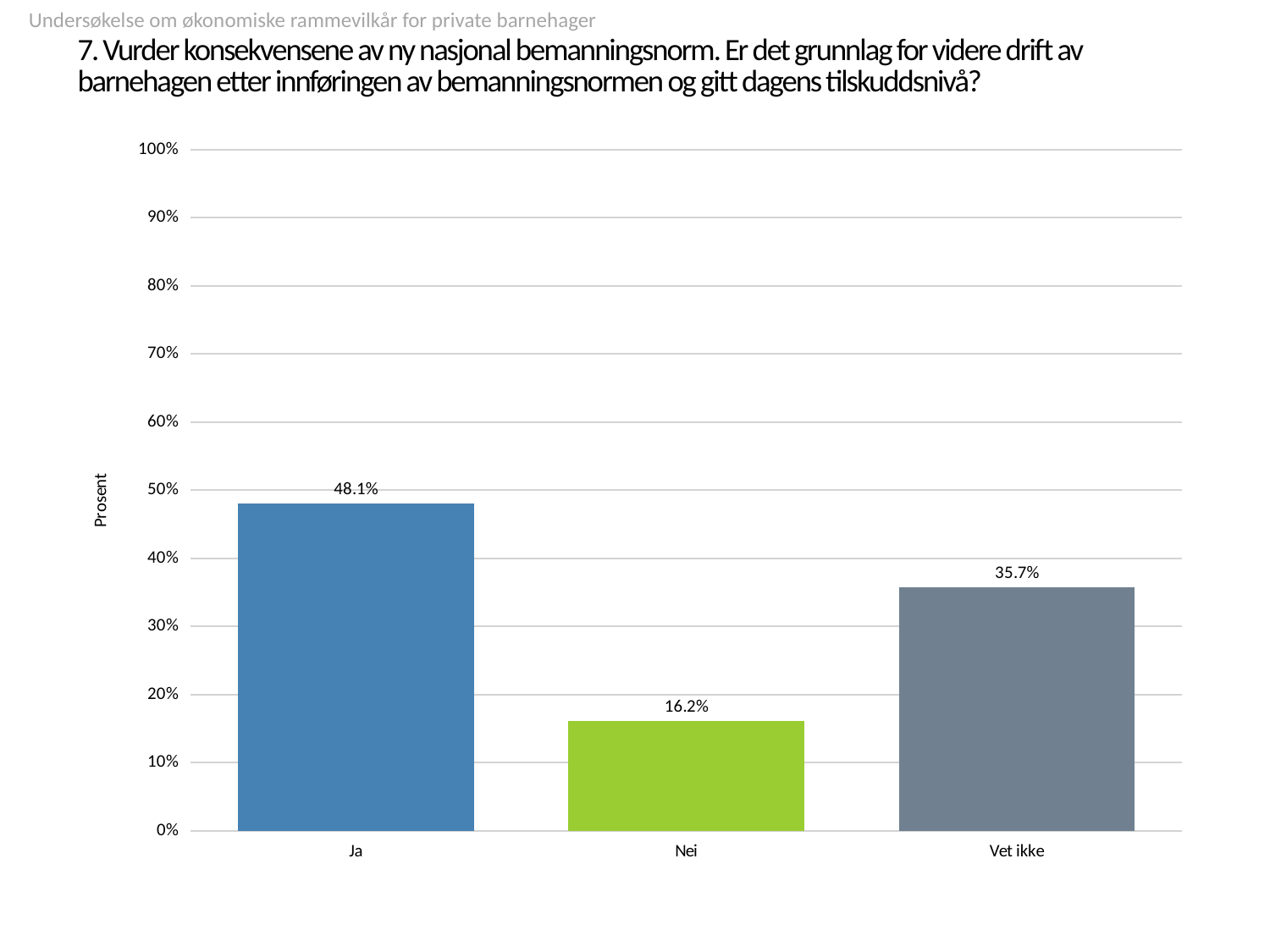
What kind of chart is shown on the slide? bar chart What is the label of the y axis? Prosent What is the value for "Ja"? 48.1% What is the value for "Vet ikke"? 35.7% Which category has the lowest value? Nei What is the difference between the values for "Vet ikke" and "Nei"? 19.5% What is the value for "Nei"? 16.2% What is the difference between the values for "Ja" and "Vet ikke"? 12.4% Which is larger, the value for "Nei" or the value for "Vet ikke"? Vet ikke How many categories are shown on the x axis? 3 Is the value for "Ja" greater or less than 50%? less Which category has the highest value? Ja